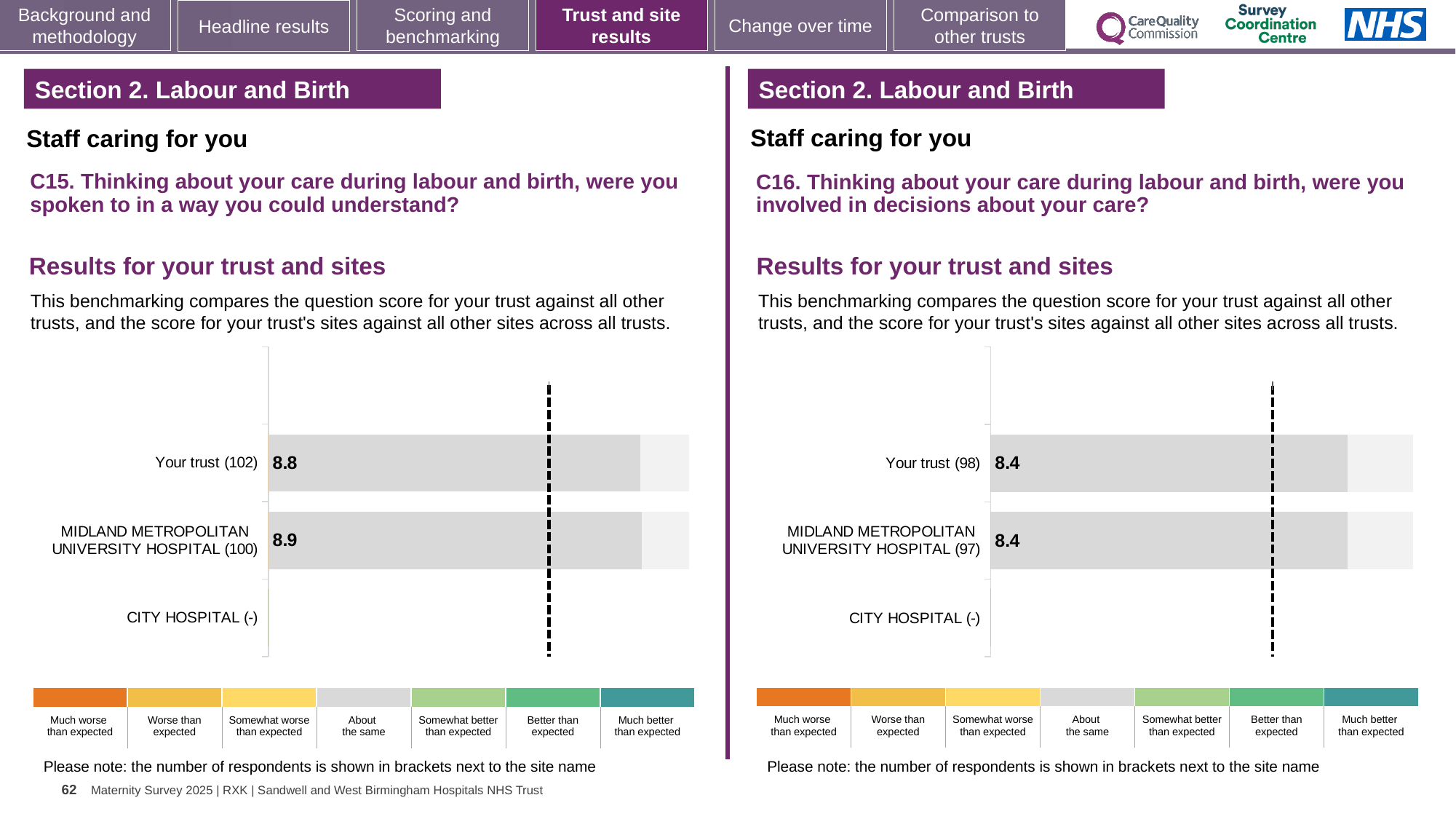
How many categories are listed on the y axis of the C15 chart on the left? 3 In the C15 chart on the left, which has the higher score: Your trust or MIDLAND METROPOLITAN UNIVERSITY HOSPITAL? MIDLAND METROPOLITAN UNIVERSITY HOSPITAL In the C16 chart on the right, what is the score for Your trust (98)? 8.4 In the C15 chart on the left, what is the score for Your trust (102)? 8.8 In the C15 chart on the left, what is the score for MIDLAND METROPOLITAN UNIVERSITY HOSPITAL (100)? 8.9 In the C15 chart on the left, what is the difference between the MIDLAND METROPOLITAN UNIVERSITY HOSPITAL score and the Your trust score? 0.1 In the C16 chart on the right, which category has no bar plotted? CITY HOSPITAL (-) In the C16 chart on the right, what is the score for MIDLAND METROPOLITAN UNIVERSITY HOSPITAL (97)? 8.4 How many categories are listed on the y axis of the C16 chart on the right? 3 What kind of chart is the C16 chart on the right? Bar chart In the C16 chart on the right, what is the difference between the Your trust score and the MIDLAND METROPOLITAN UNIVERSITY HOSPITAL score? 0 In the C15 chart on the left, how many respondents are shown in brackets for Your trust? 102